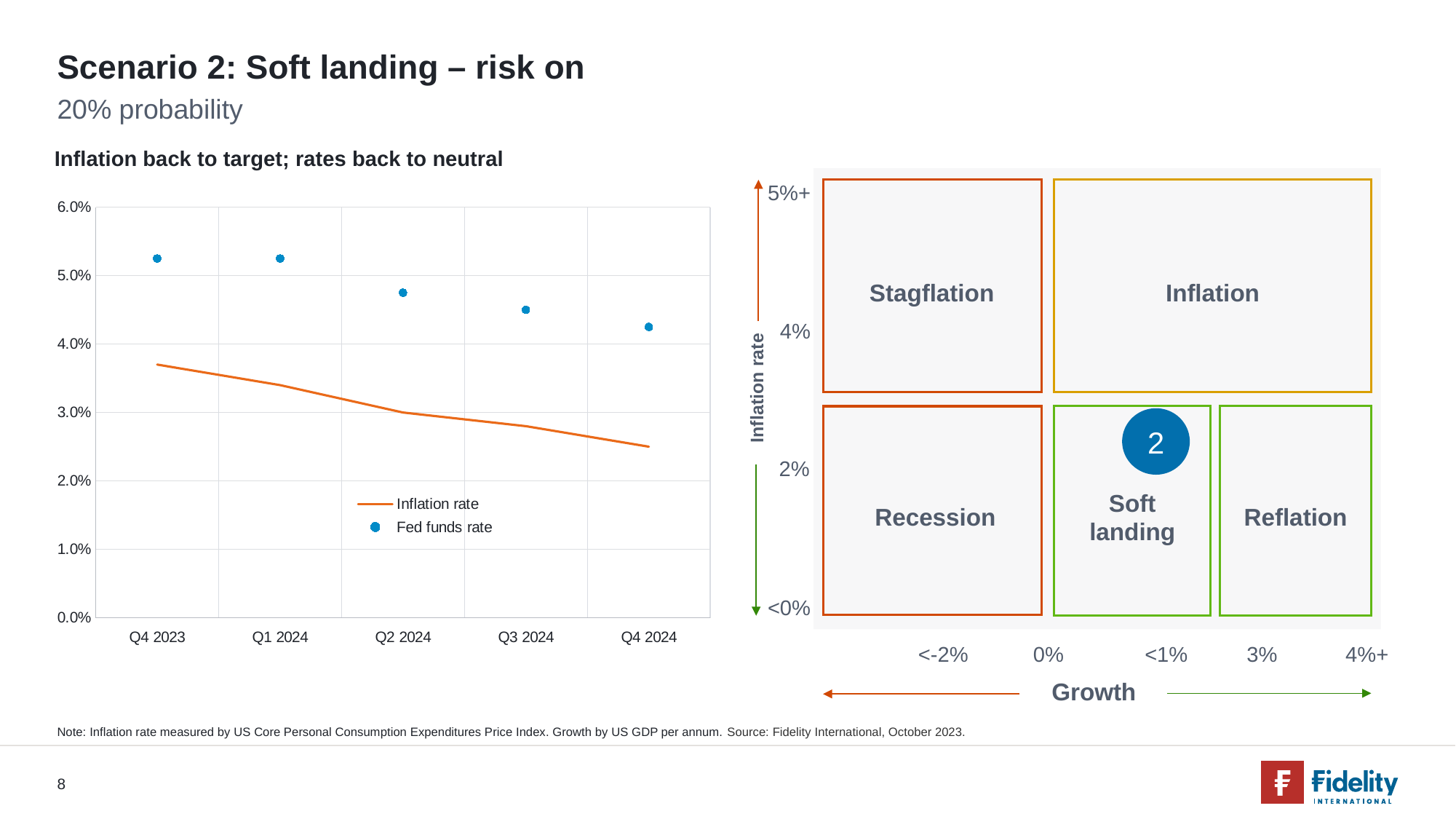
What is the title of the chart on the left of the slide? Inflation back to target; rates back to neutral In the left chart, is the Fed funds rate for Q4 2024 greater or less than 5.0%? less In the left chart, is the inflation rate for Q4 2023 greater or less than 3.0%? greater In the left chart, is the inflation rate for Q4 2024 greater or less than 3.0%? less In the left chart, which is larger in Q4 2024: the Fed funds rate or the inflation rate? Fed funds rate What kind of chart is shown on the left of the slide? line chart Does the inflation rate rise or fall from Q4 2023 to Q4 2024 in the left chart? fall Does the Fed funds rate rise or fall across the quarters shown in the left chart? fall In the left chart, which quarter has the highest inflation rate? Q4 2023 How many quarters are shown on the x axis of the left chart? 5 How many series does the legend of the left chart list? 2